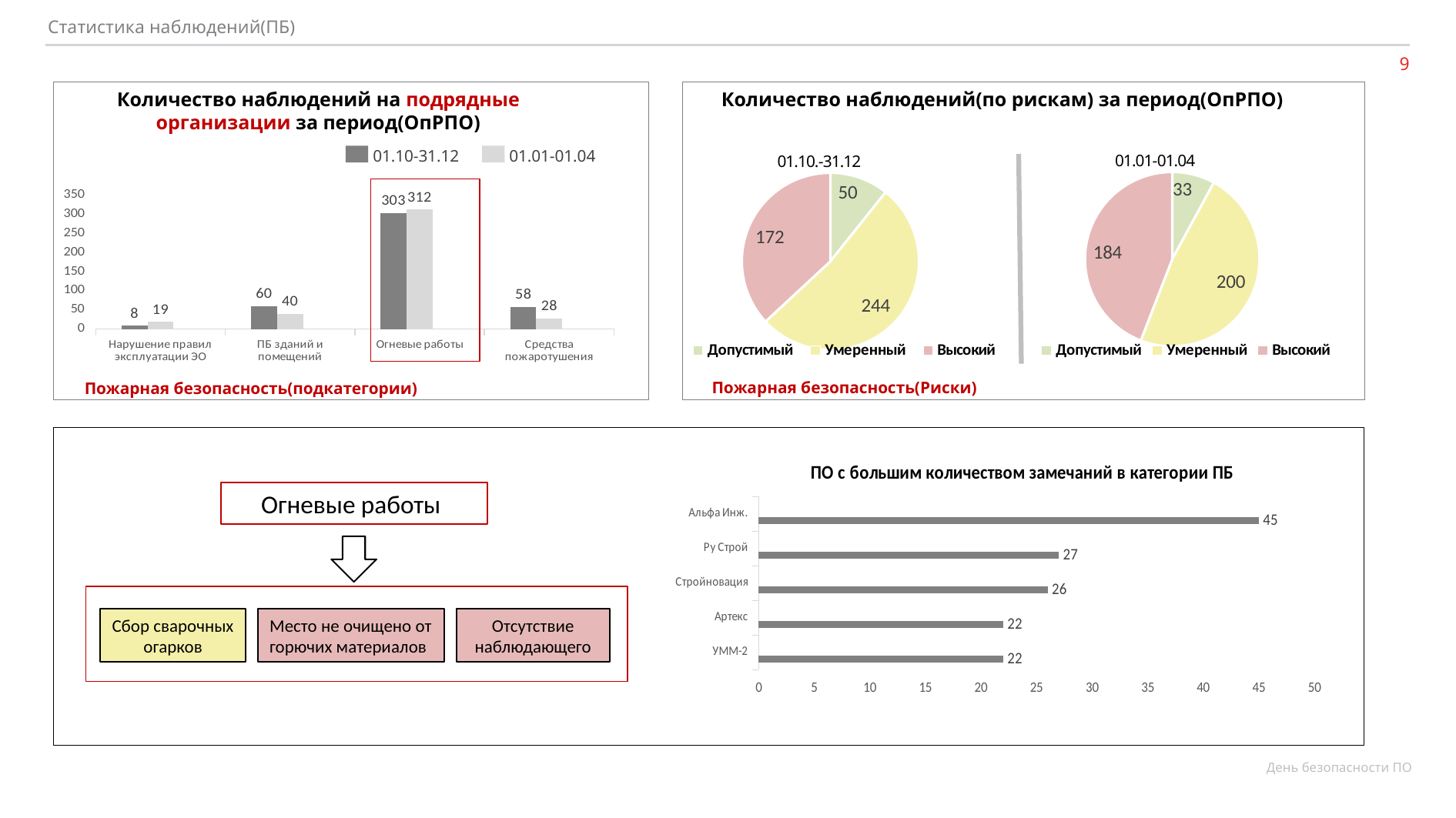
In the chart 'Количество наблюдений на подрядные организации за период(ОпРПО)', what is the difference between the 01.01-01.04 and 01.10-31.12 values for Огневые работы? 9 In the chart 'Количество наблюдений на подрядные организации за период(ОпРПО)', which category has the highest value in the 01.01-01.04 series? Огневые работы In the pie chart for 01.01-01.04 (top right), which risk level has the smallest slice? Допустимый What kind of chart is 'ПО с большим количеством замечаний в категории ПБ' (bottom right)? bar chart In the chart 'ПО с большим количеством замечаний в категории ПБ', which organisation has the highest value? Альфа Инж. In the pie chart for 01.10.-31.12 (top right), what is the value for Умеренный? 244 In the chart 'ПО с большим количеством замечаний в категории ПБ', what is the difference between the values for Альфа Инж. and Ру Строй? 18 In the pie chart for 01.01-01.04 (top right), what is the value for Высокий? 184 How many series does the legend of the chart 'Количество наблюдений на подрядные организации за период(ОпРПО)' list? 2 In the chart 'Количество наблюдений на подрядные организации за период(ОпРПО)', what is the value for Средства пожаротушения in the 01.01-01.04 series? 28 How many categories are shown on the x axis of the chart 'Количество наблюдений на подрядные организации за период(ОпРПО)'? 4 In the chart 'Количество наблюдений на подрядные организации за период(ОпРПО)', what is the value for Огневые работы in the 01.10-31.12 series? 303